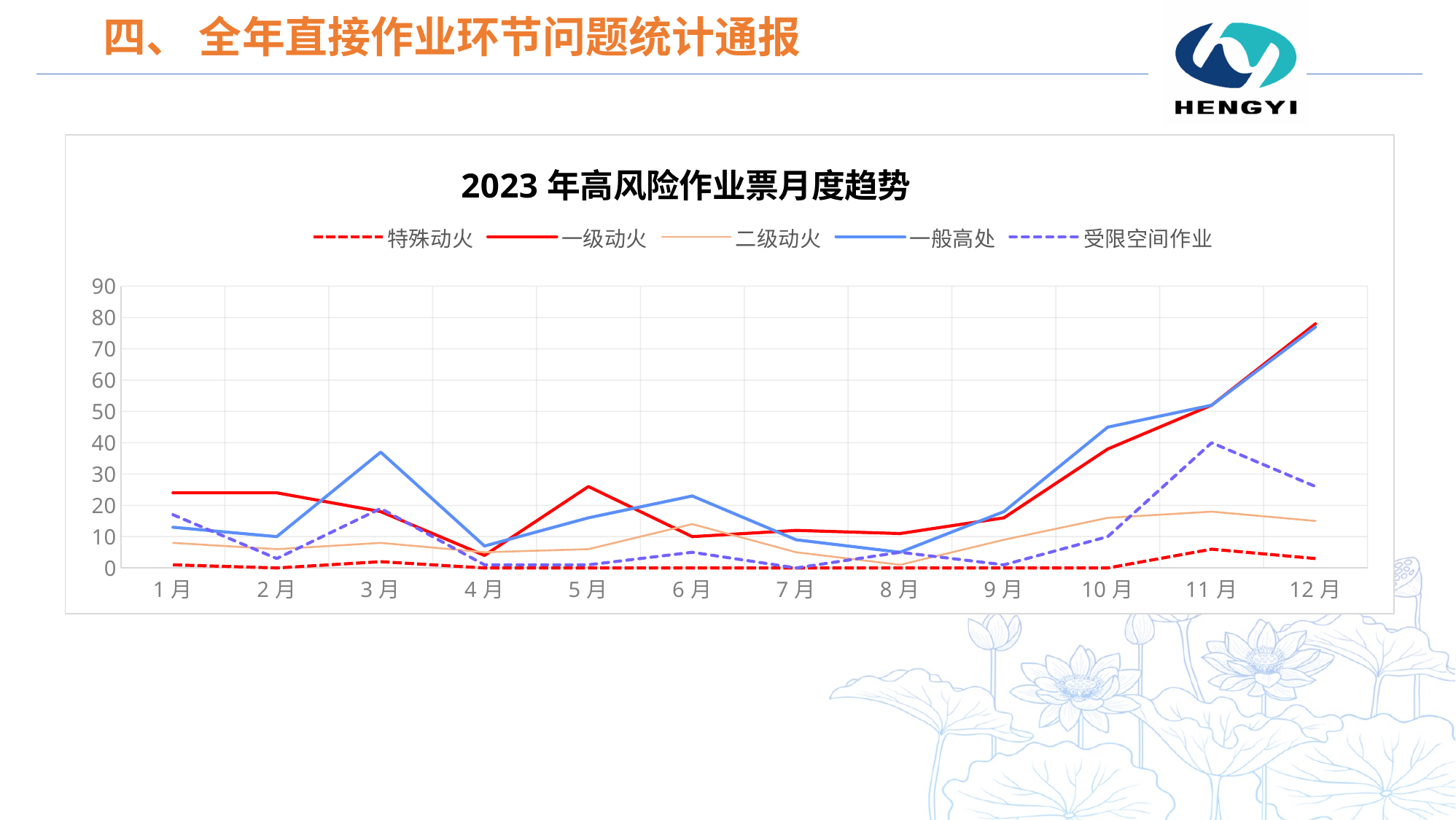
What is the title of the chart? 2023 年高风险作业票月度趋势 Does the 一级动火 series rise or fall from 9月 to 12月? rise What kind of chart is shown on the slide? line chart In which month does the 一级动火 series reach its lowest value? 4月 How many series does the legend of the chart list? 5 In which month does the 一级动火 series reach its highest value? 12月 Is the value for 一级动火 in 12月 greater or less than 70? greater In which month does the 受限空间作业 series reach its highest value? 11月 Is the value for 一般高处 in 3月 greater or less than 30? greater Is the value for 受限空间作业 in 11月 greater or less than 30? greater In 3月, which series has the larger value, 一般高处 or 一级动火? 一般高处 How many months are plotted along the x axis of the chart? 12